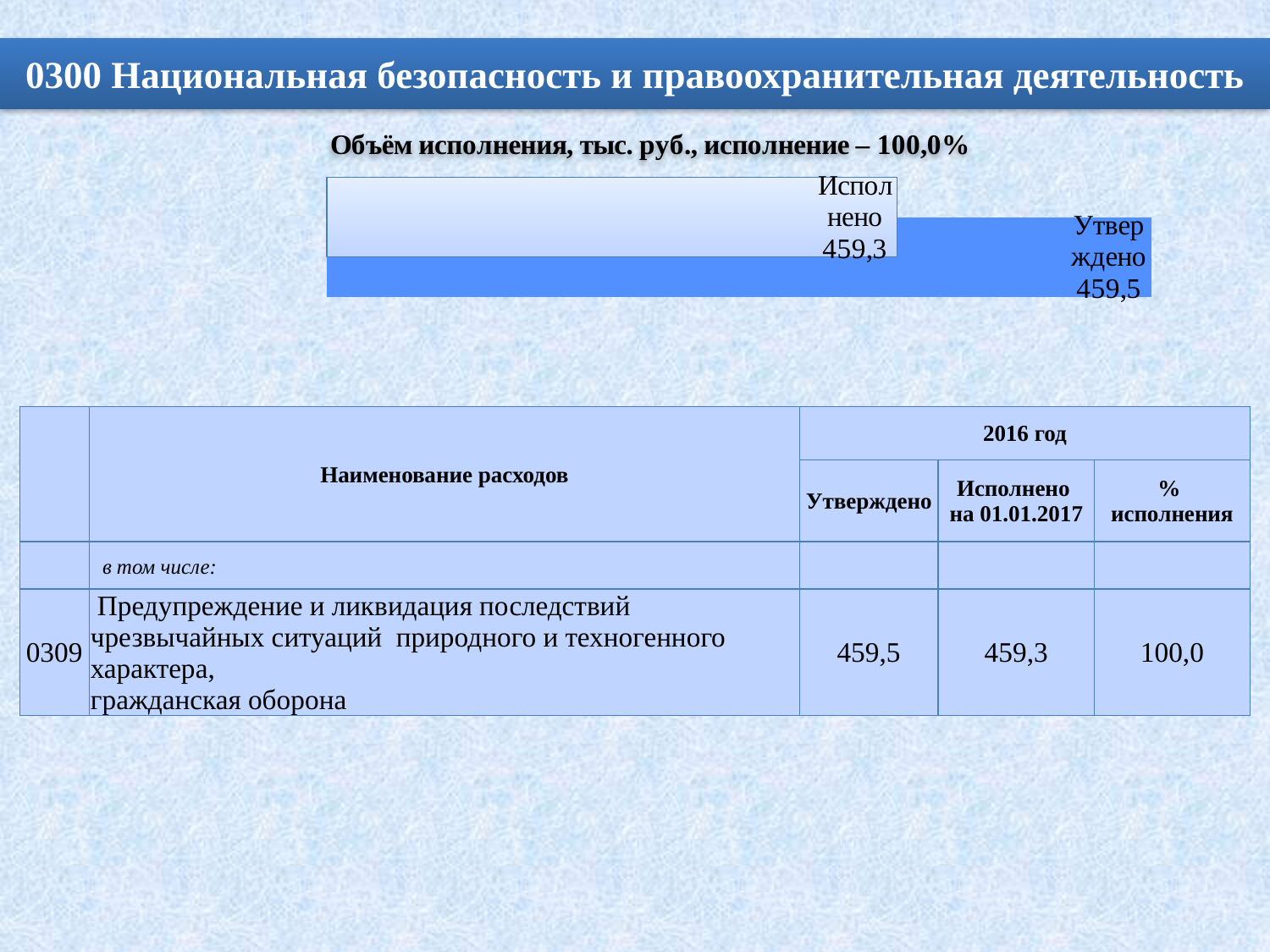
What is the title of the chart? Объём исполнения, тыс. руб., исполнение – 100,0% What is the value of the Исполнено bar in the chart? 459,3 What is the difference between the Утверждено and Исполнено values in the chart? 0,2 How many bars are shown in the chart? 2 According to the printed data labels, which bar has the larger value: Утверждено or Исполнено? Утверждено Is the value for Исполнено in the chart greater or less than 400? greater What is the value of the Утверждено bar in the chart? 459,5 Is the value for Утверждено in the chart greater or less than 500? less What kind of chart is shown on the slide? Bar chart What colour is the Утверждено bar in the chart? Blue